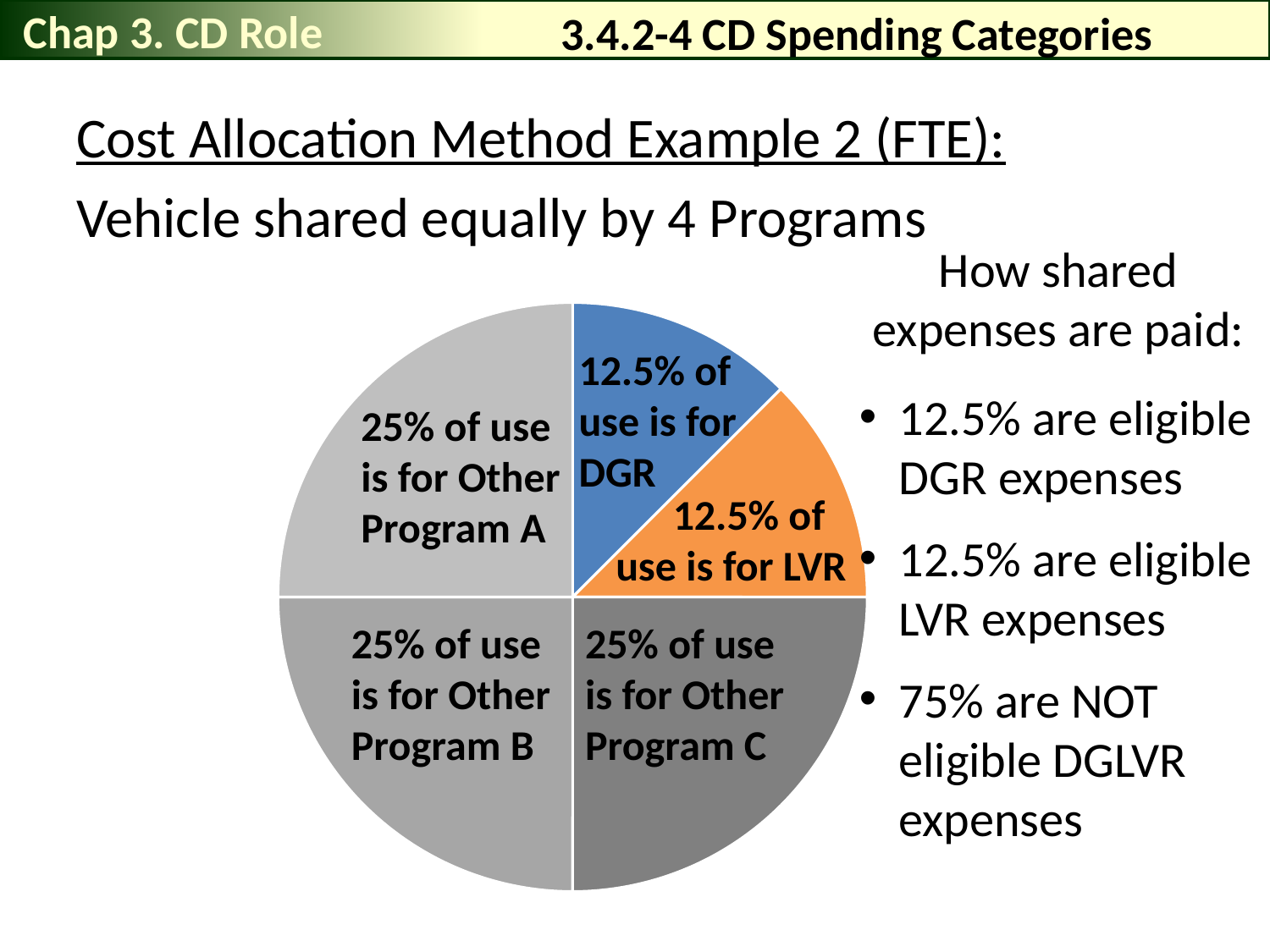
What share of use is for LVR? 12.5% What share of use is for Other Program C? 25% What share of use is for DGR? 12.5% What is the difference between the share for Other Program A and the share for LVR? 12.5% What colour is the slice for DGR? blue What colour is the slice for LVR? orange What is the combined share of use for Other Programs A, B and C? 75% What is the combined share of use for DGR and LVR? 25% Which is larger, the share for Other Program B or the share for DGR? Other Program B How many slices does the pie chart have? 5 What kind of chart is shown on the slide? pie chart